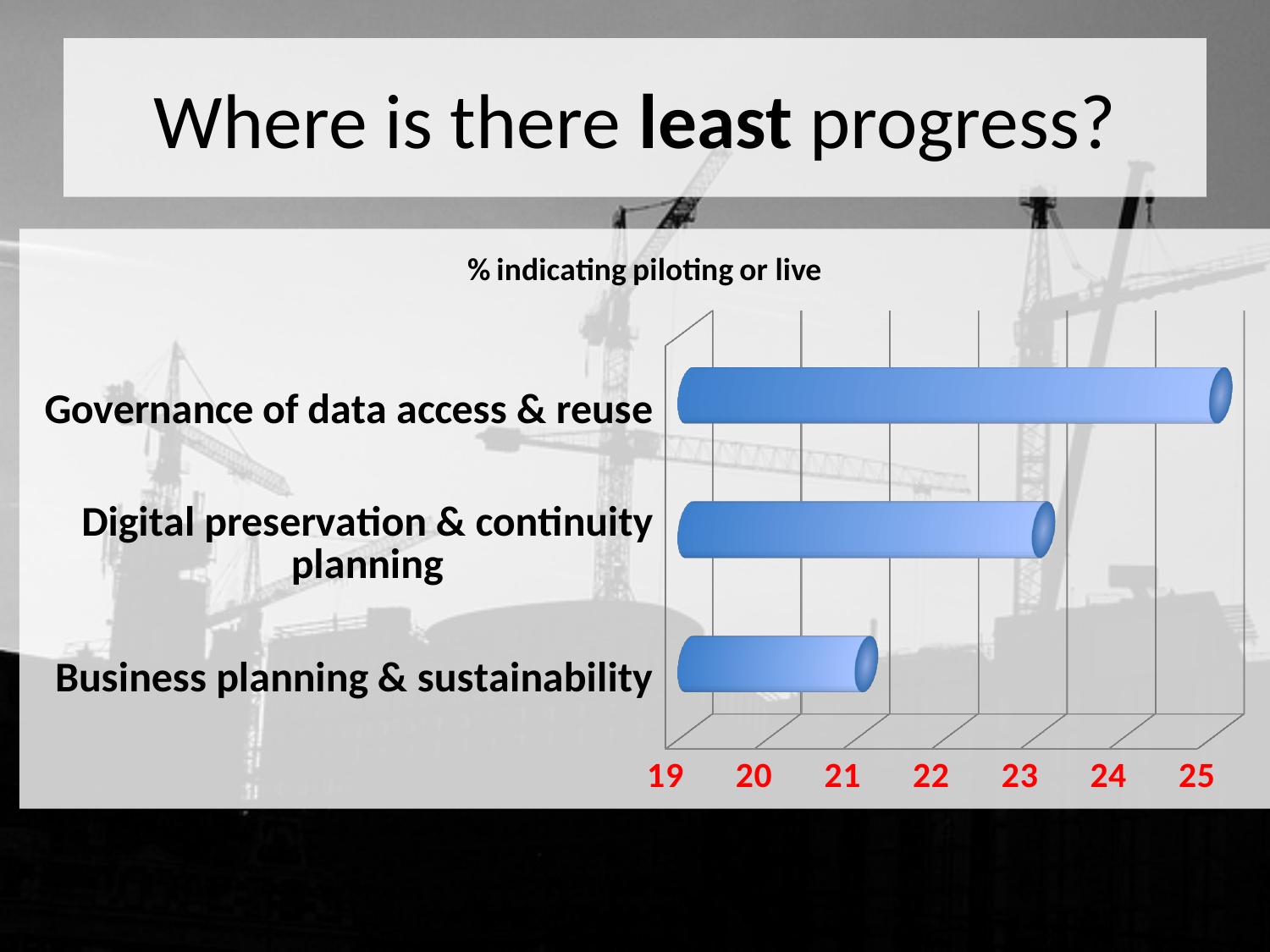
Is the value for Digital preservation & continuity planning greater or less than 22? greater Which is larger: the value for Governance of data access & reuse or the value for Business planning & sustainability? Governance of data access & reuse How many categories are plotted in the chart? 3 Is the value for Business planning & sustainability greater or less than 22? less Is the value for Digital preservation & continuity planning greater or less than 24? less Which category has the highest value? Governance of data access & reuse What is the title of the chart? % indicating piloting or live What is the lowest value shown on the horizontal axis of the chart? 19 What kind of chart is shown on the slide? bar chart Which is larger: the value for Digital preservation & continuity planning or the value for Business planning & sustainability? Digital preservation & continuity planning Which category has the lowest value? Business planning & sustainability